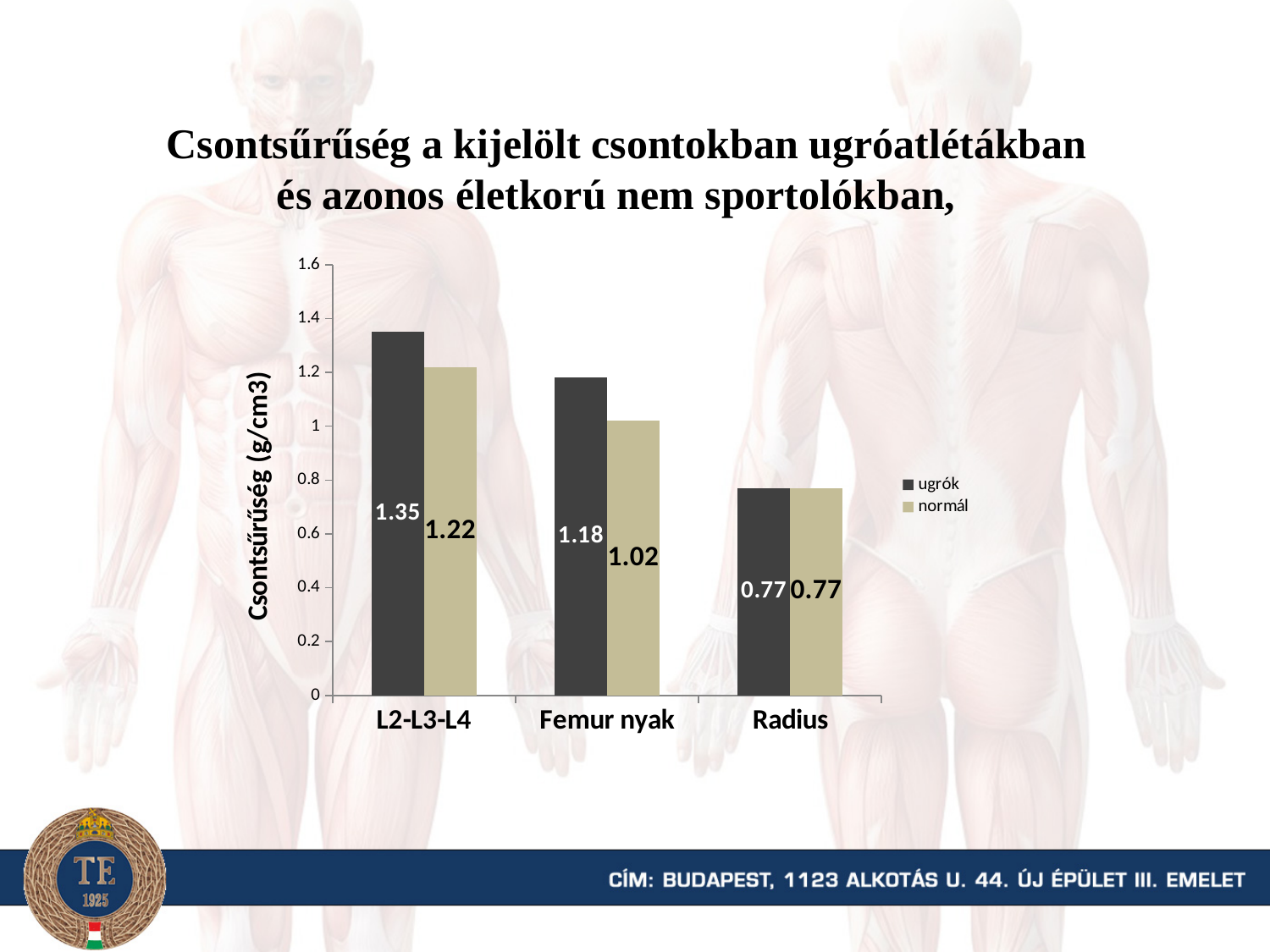
What is the bone density value for ugrók at Radius? 0.77 How many series does the legend list? 2 Which category has the lowest value for the normál series? Radius What is the bone density value for normál at Femur nyak? 1.02 What is the difference between the ugrók and normál values at Femur nyak? 0.16 What is the bone density value for ugrók at L2-L3-L4? 1.35 What is the difference between the ugrók and normál values at L2-L3-L4? 0.13 Which category has the highest value for the ugrók series? L2-L3-L4 At Femur nyak, which series has the larger value, ugrók or normál? ugrók How many categories are shown on the x axis? 3 What kind of chart is shown on the slide? bar chart What is the label of the y axis? Csontsűrűség (g/cm3)